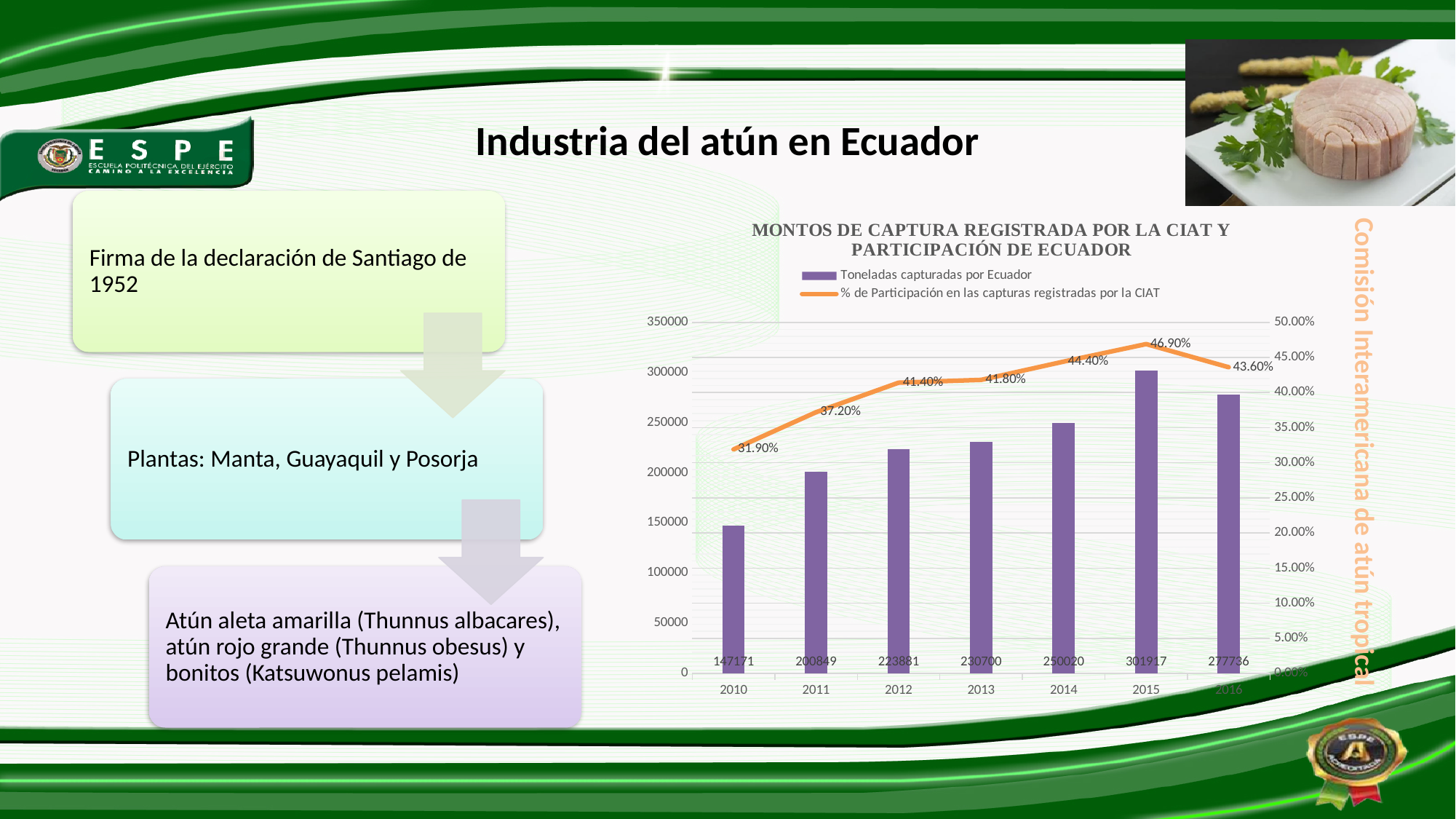
Does the % de Participación en las capturas registradas por la CIAT rise or fall from 2010 to 2015? Rise What is the title of the chart? MONTOS DE CAPTURA REGISTRADA POR LA CIAT Y PARTICIPACIÓN DE ECUADOR How many series does the legend list? 2 What is the value of Toneladas capturadas por Ecuador for 2012? 223881 How many years are shown on the x axis of the chart? 7 Which year has the larger % de Participación en las capturas registradas por la CIAT, 2014 or 2016? 2014 What is the difference in Toneladas capturadas por Ecuador between 2015 and 2016? 24181 Which year has the lowest % de Participación en las capturas registradas por la CIAT? 2010 What is the value of Toneladas capturadas por Ecuador for 2015? 301917 What kind of chart is used to show Toneladas capturadas por Ecuador? Bar chart What is the % de Participación en las capturas registradas por la CIAT for 2010? 31.90% Which year has the highest Toneladas capturadas por Ecuador? 2015